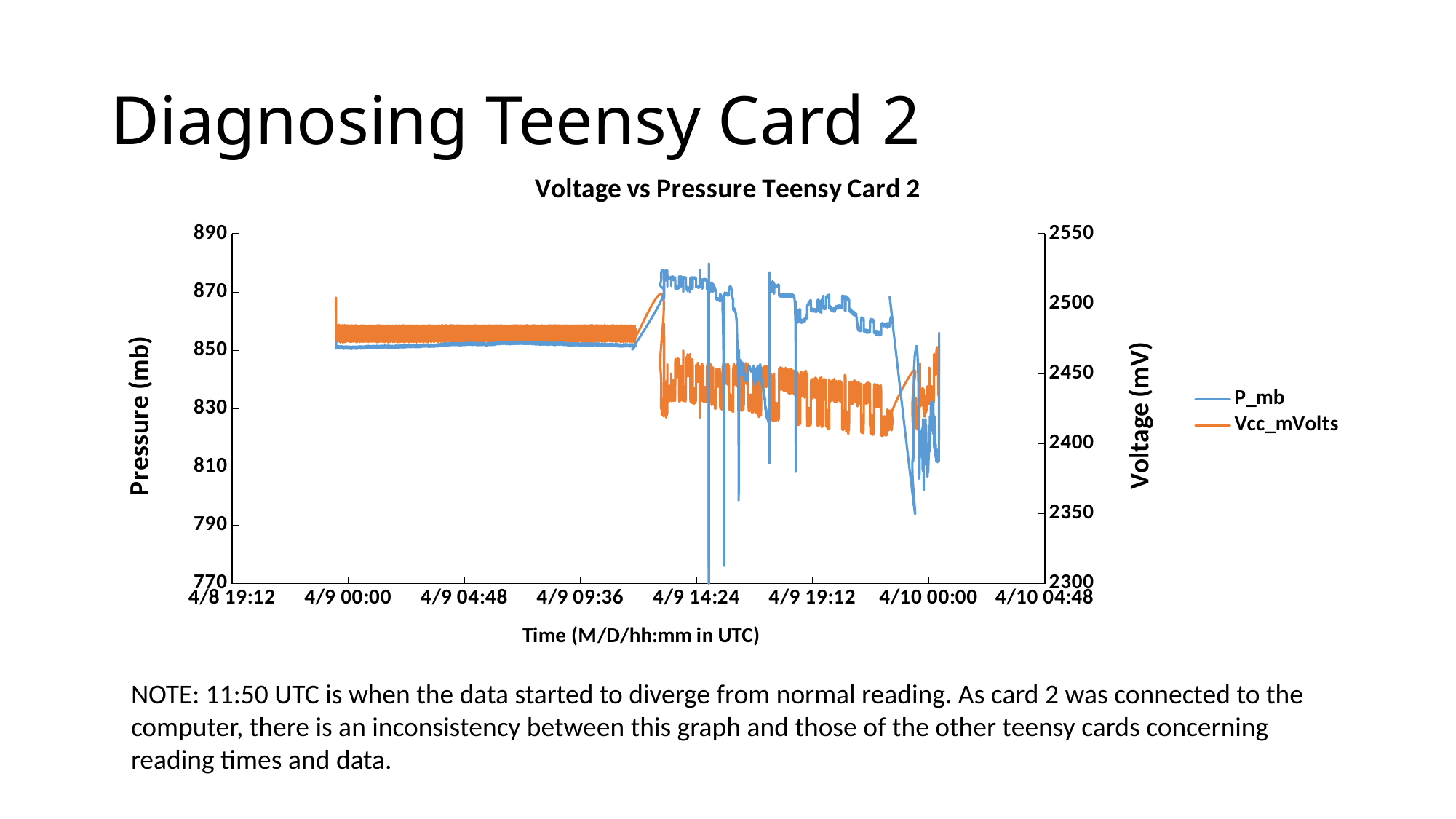
Is the value of Vcc_mVolts at 4/9 19:12 greater or less than 2500? less Is P_mb larger at 4/9 04:48 or at 4/9 19:12? 4/9 19:12 Does Vcc_mVolts generally rise or fall between 4/9 14:24 and 4/9 19:12? fall What kind of chart is shown on the slide? line chart How many series does the legend list? 2 Is the value of P_mb at 4/9 04:48 greater or less than 870? less Is the value of Vcc_mVolts at 4/9 04:48 greater or less than 2450? greater What is the title of the chart? Voltage vs Pressure Teensy Card 2 How many time labels are shown on the x axis? 8 Which series is drawn in orange? Vcc_mVolts Is Vcc_mVolts larger at 4/9 04:48 or at 4/9 19:12? 4/9 04:48